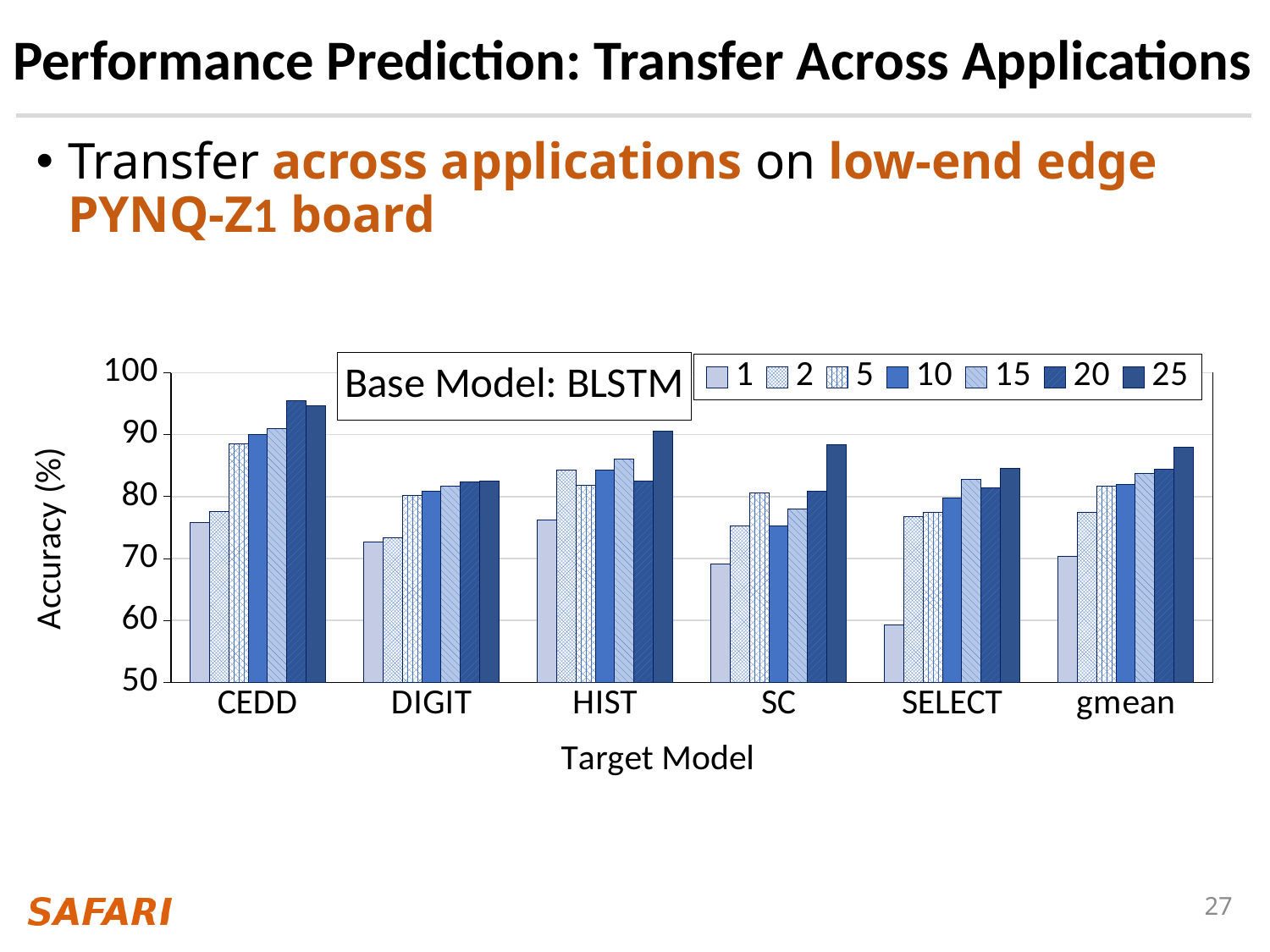
Is the accuracy for series 20 on CEDD greater or less than 90? greater How many target model categories are shown on the x axis? 6 Which series has the highest accuracy for SC? 25 What kind of chart is shown on the slide? bar chart Is the accuracy for series 1 on SELECT greater or less than 60? less Is the accuracy for series 1 on SC greater or less than 70? less Which series has the lowest accuracy for SELECT? 1 How many series does the legend list? 7 What is the title of the x axis? Target Model What base model is named in the text box inside the chart? BLSTM For series 1, which has the larger accuracy: CEDD or SELECT? CEDD